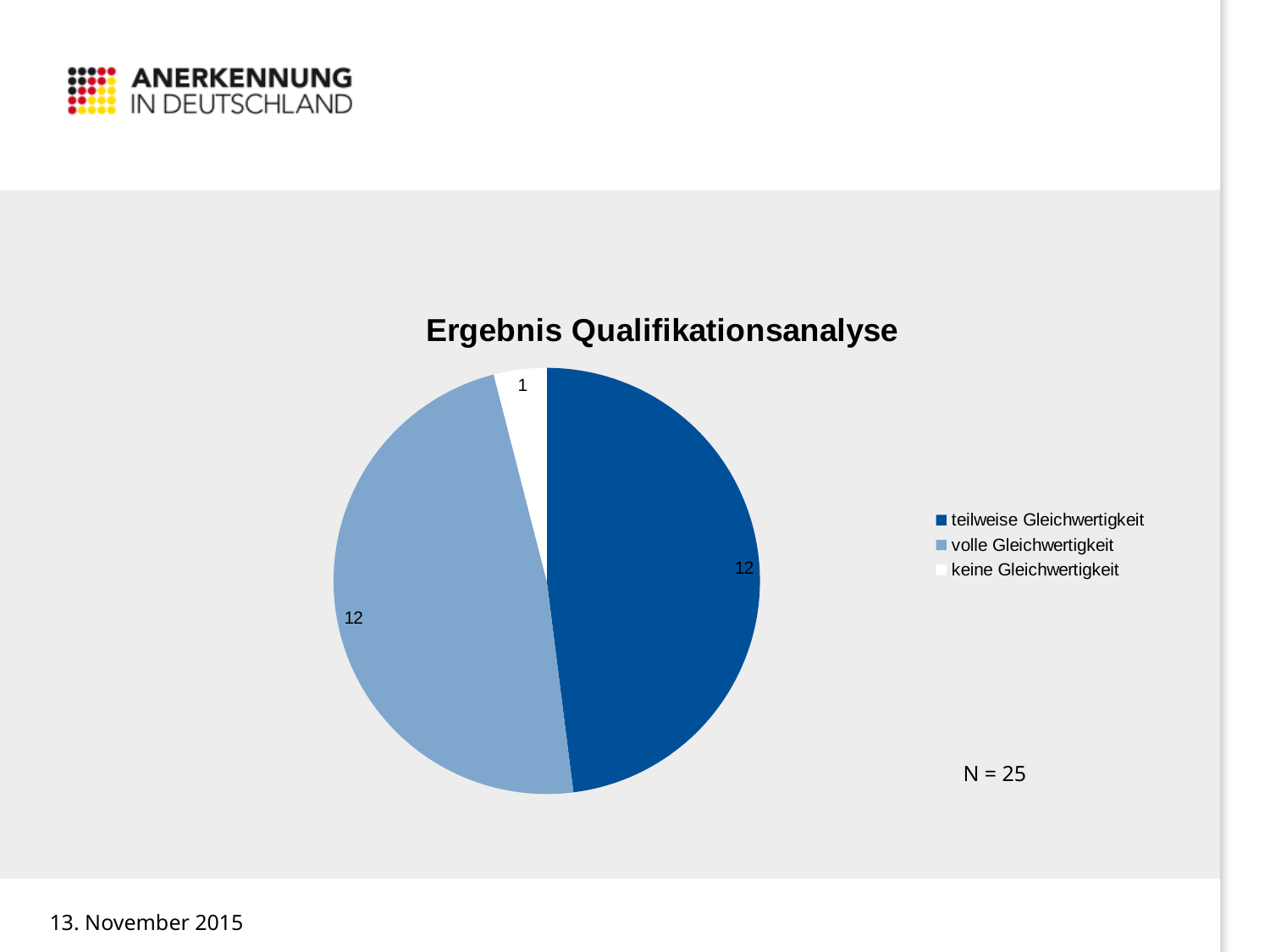
What is the title of the chart? Ergebnis Qualifikationsanalyse How many entries does the legend list? 3 Which is larger, the value for volle Gleichwertigkeit or keine Gleichwertigkeit? volle Gleichwertigkeit What is the value for teilweise Gleichwertigkeit? 12 How many slices does the pie chart have? 3 What is the value for keine Gleichwertigkeit? 1 What is the total of all slices in the pie chart? 25 Which category has the smallest slice? keine Gleichwertigkeit What share of the pie does keine Gleichwertigkeit represent? 4% What is the difference between the values for teilweise Gleichwertigkeit and keine Gleichwertigkeit? 11 What kind of chart is shown on the slide? pie chart What is the value for volle Gleichwertigkeit? 12